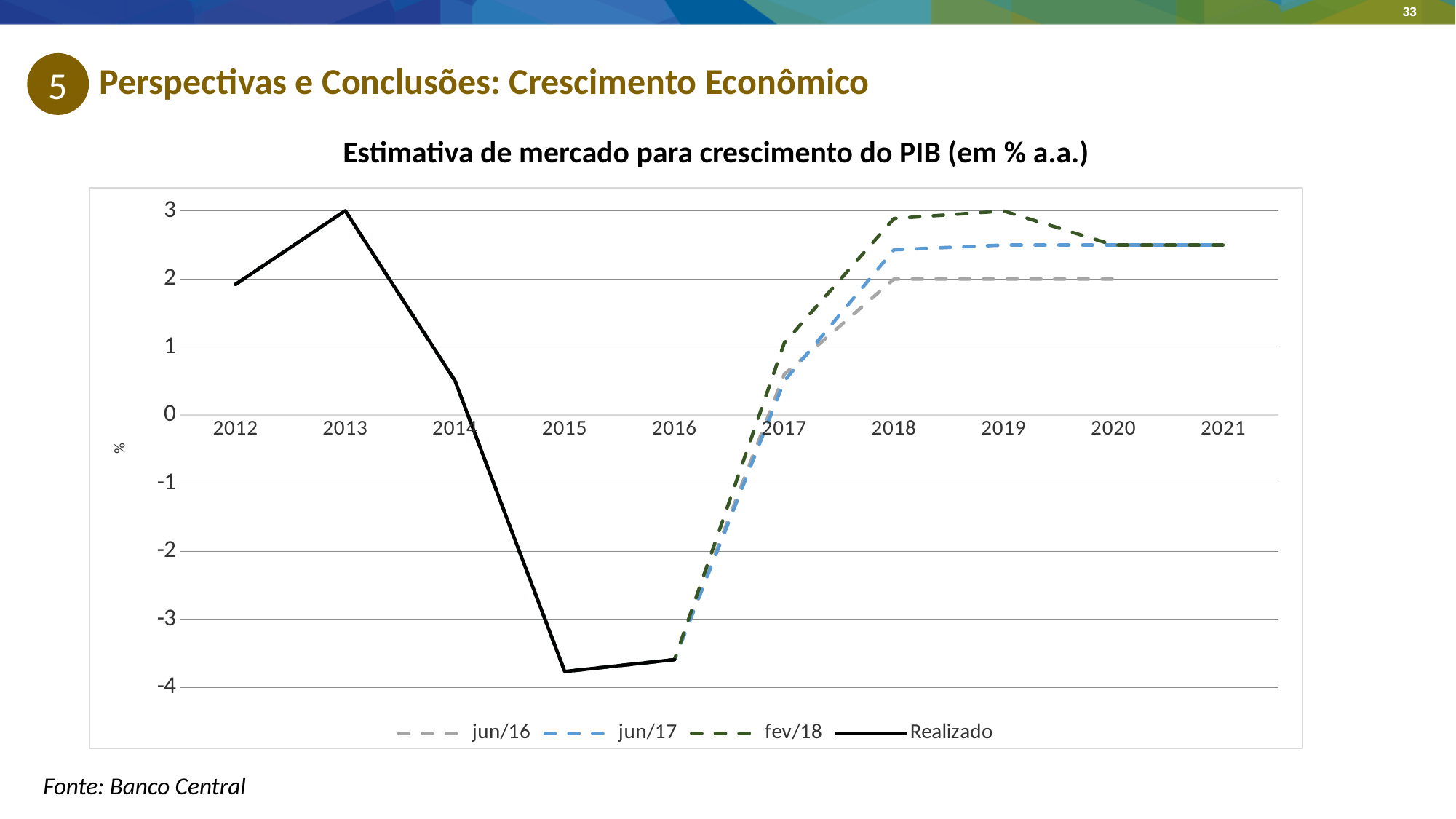
Which legend entry is drawn as a solid black line? Realizado Does the Realizado series rise or fall from 2013 to 2015? fall In 2018, which series is higher: fev/18 or jun/16? fev/18 Is the Realizado value for 2012 greater or less than 1? greater Is the Realizado value for 2015 greater or less than -3? less What kind of chart is shown on the slide? line chart How many years are shown on the x axis? 10 How many series does the legend list? 4 In which year does the Realizado series reach its lowest value? 2015 What is the title of the chart? Estimativa de mercado para crescimento do PIB (em % a.a.) In which year does the Realizado series reach its highest value? 2013 Is the fev/18 value for 2017 greater or less than 0? greater